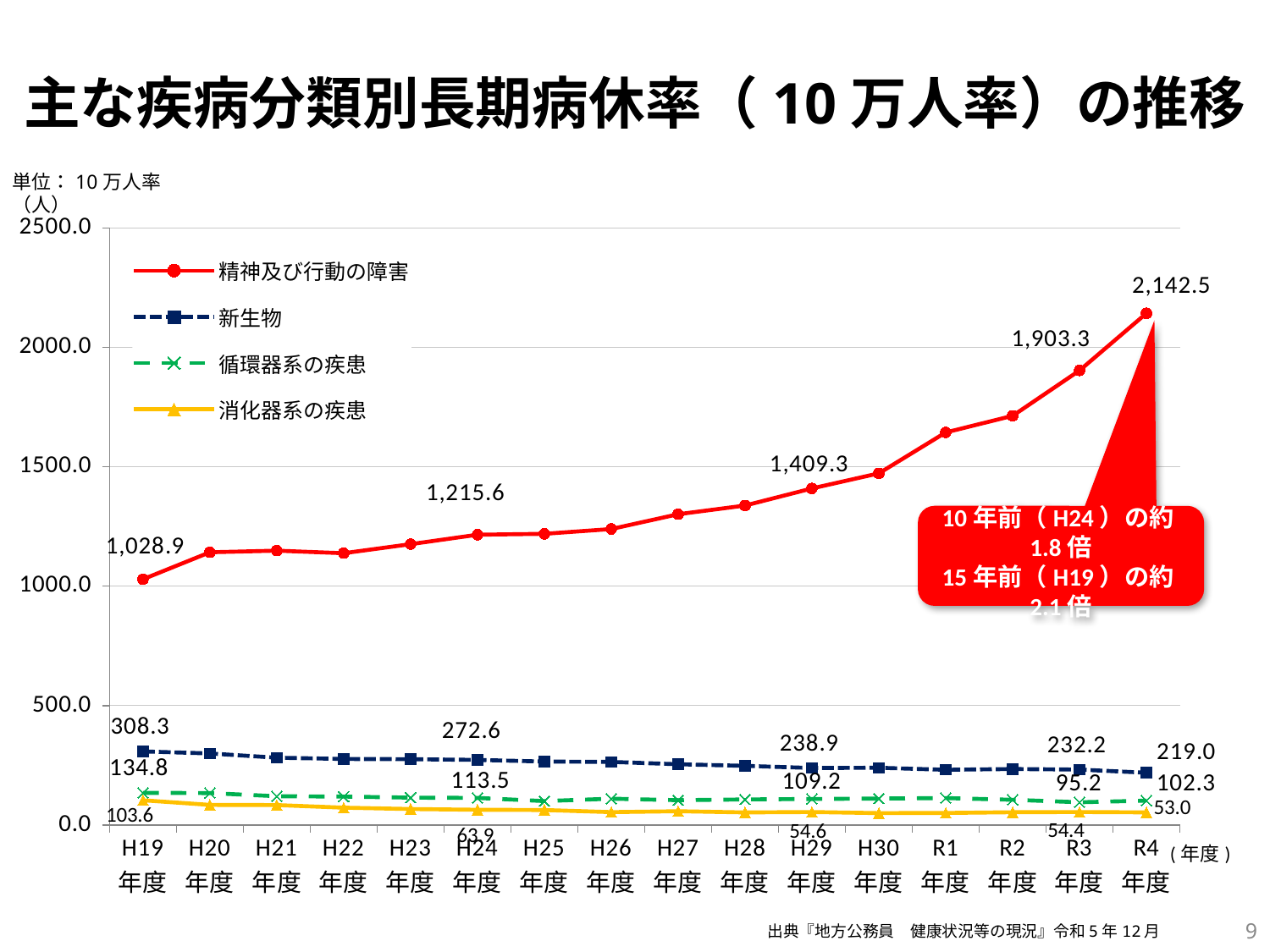
What is the value for 新生物 in H19年度? 308.3 What is the value for 循環器系の疾患 in H29年度? 109.2 Is the value for 精神及び行動の障害 in H30年度 greater or less than 1500.0? less How many series does the legend list? 4 Which series has the lowest value in H24年度? 消化器系の疾患 How many fiscal years are plotted along the x axis? 16 What kind of chart is shown on the slide? line chart What is the value for 消化器系の疾患 in R3年度? 54.4 Which series has the highest value in R4年度? 精神及び行動の障害 What is the value for 精神及び行動の障害 in R4年度? 2,142.5 Does the 精神及び行動の障害 series generally rise or fall from H19年度 to R4年度? rise What is the difference between the 精神及び行動の障害 values in R4年度 and H19年度? 1,113.6